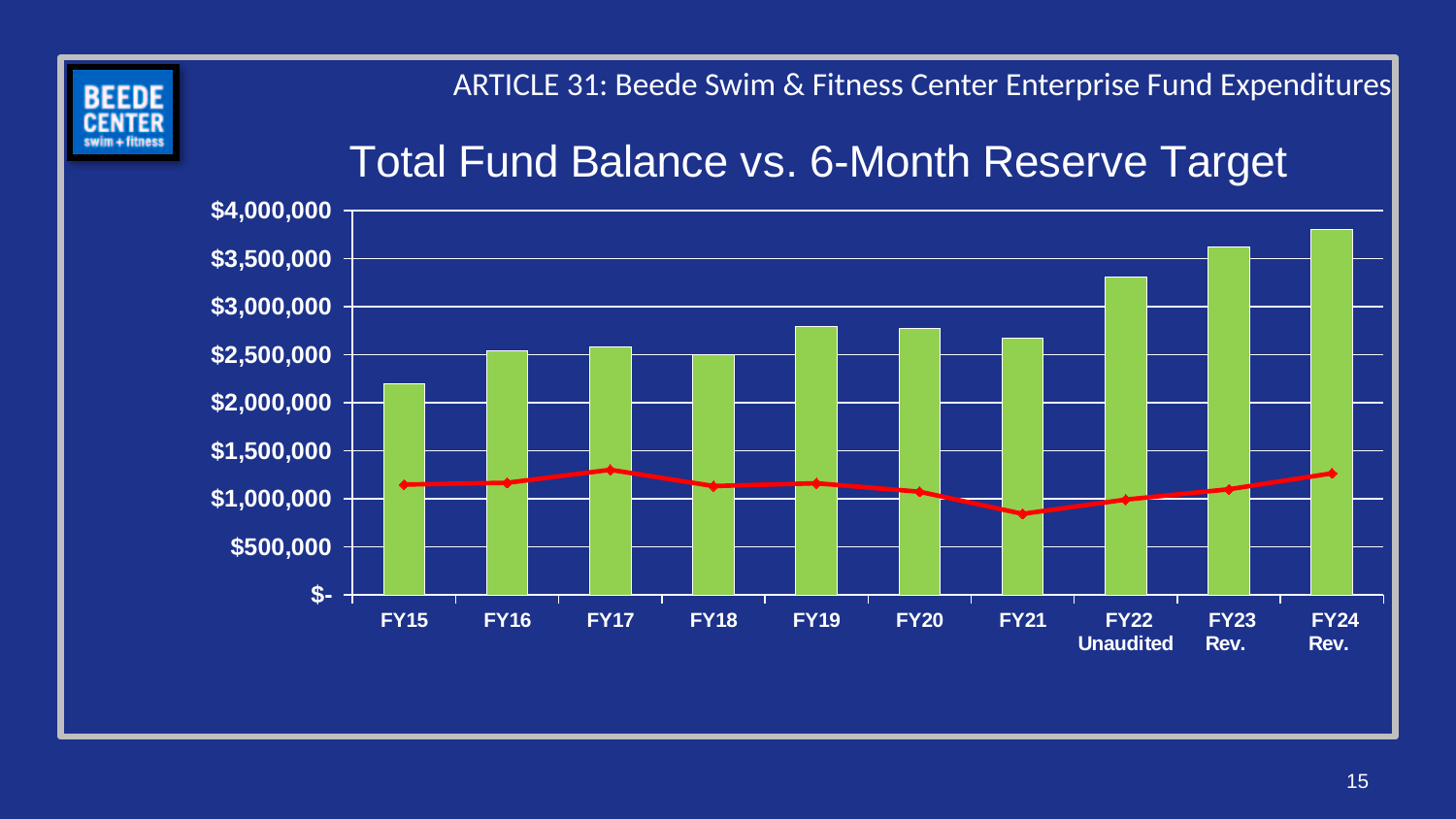
How many fiscal-year categories are shown on the x axis? 10 Which fiscal year has the tallest bar? FY24 Rev. At which fiscal year does the red line reach its lowest point? FY21 Do the bar values generally rise or fall from FY21 to FY24 Rev.? rise Is the bar value for FY15 greater or less than $2,500,000? less What is the title of the chart? Total Fund Balance vs. 6-Month Reserve Target Is the bar value for FY24 Rev. greater or less than $3,500,000? greater Is the bar value for FY22 Unaudited greater or less than $3,000,000? greater Which fiscal year has the shortest bar? FY15 What kind of chart is shown on the slide? Bar chart with a line Which has the taller bar, FY19 or FY22 Unaudited? FY22 Unaudited